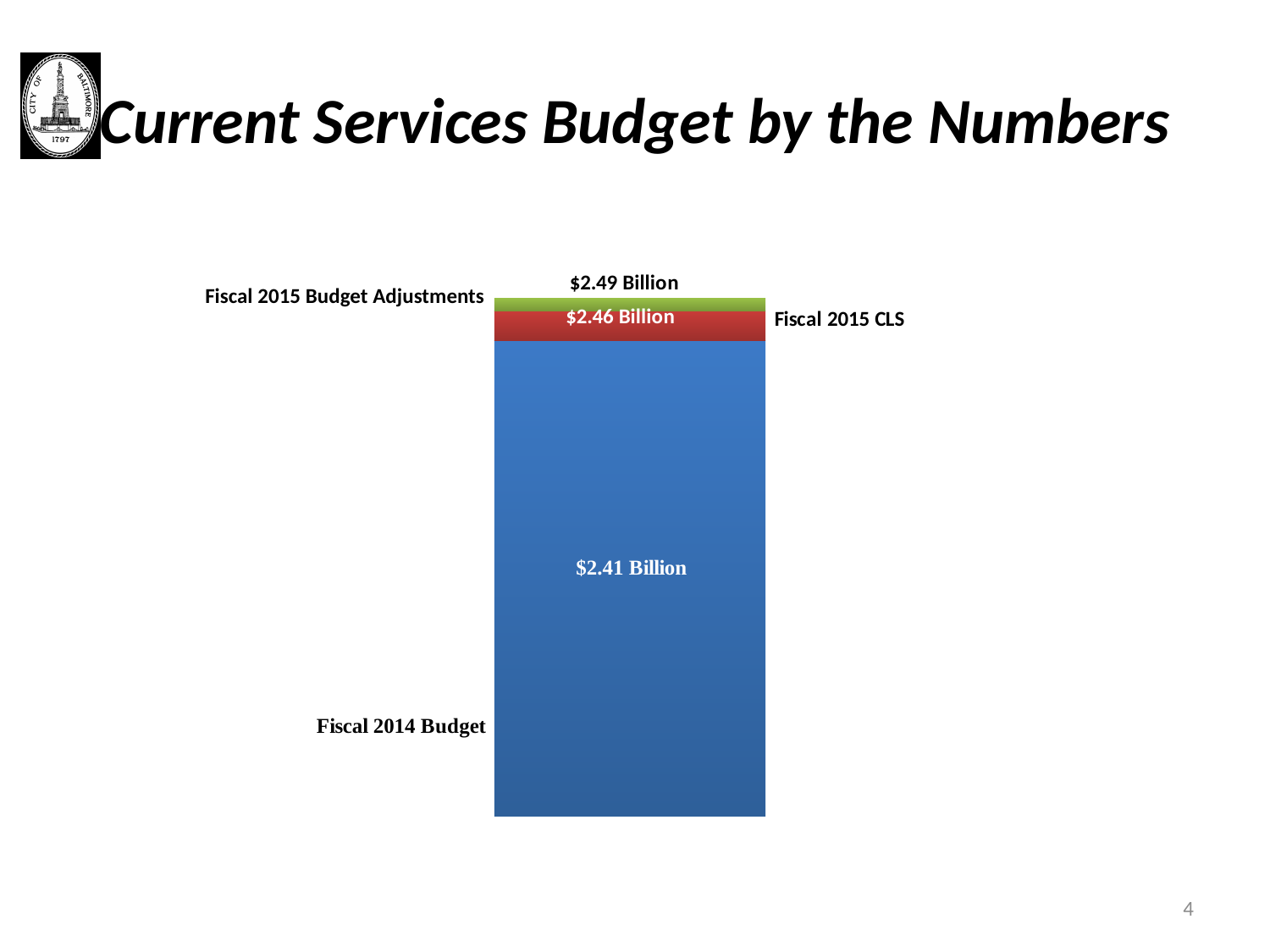
Which segment of the stacked bar is the smallest? Fiscal 2015 Budget Adjustments What value is labeled at the Fiscal 2015 CLS level of the bar? $2.46 Billion What value is labeled on the Fiscal 2014 Budget segment of the bar? $2.41 Billion What is the difference between the $2.46 Billion label and the $2.41 Billion label? $0.05 Billion What value is labeled at the top of the bar, at the Fiscal 2015 Budget Adjustments level? $2.49 Billion How many segments make up the stacked bar? 3 Which segment of the stacked bar is the largest? Fiscal 2014 Budget What colour is the Fiscal 2015 CLS segment of the bar? Red What kind of chart is shown on the slide? Stacked bar chart Which labeled value on the chart is the highest? $2.49 Billion Which labeled value on the chart is the lowest? $2.41 Billion What is the difference between the $2.49 Billion label and the $2.46 Billion label? $0.03 Billion